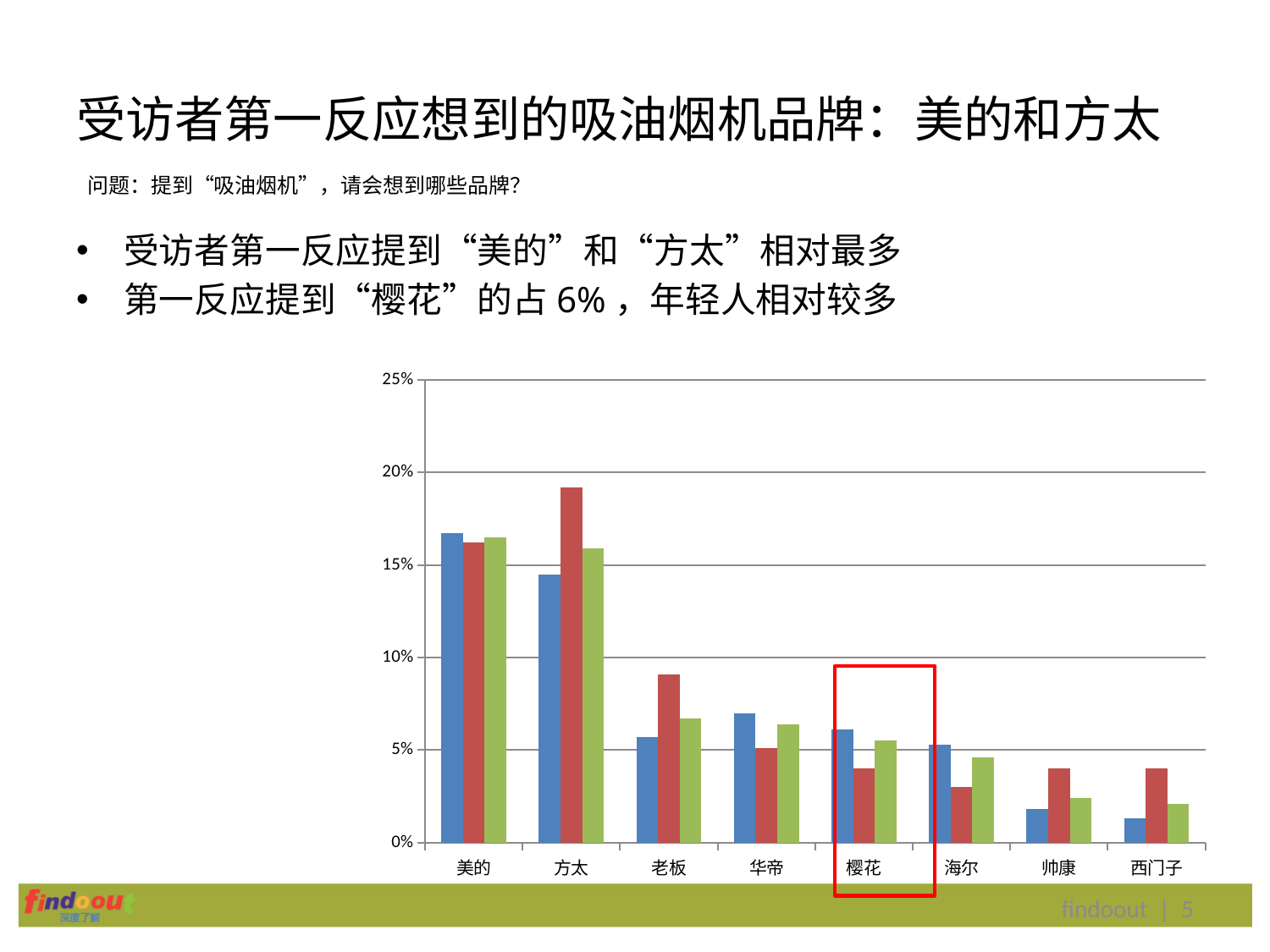
How many brand categories are shown on the x axis of the chart? 8 Which is larger, the blue bar for 美的 or the blue bar for 方太? 美的 Is the blue bar for 帅康 greater or less than 5%? less How many bars are plotted for each brand in the chart? 3 Among the red bars, which brand has the lowest value? 海尔 Which is larger, the red bar for 老板 or the green bar for 老板? red bar Is the red bar for 老板 greater or less than 10%? less Is the red bar for 方太 greater or less than 15%? greater What kind of chart is shown on the slide? bar chart Among the blue bars, which brand has the highest value? 美的 Which brand has the tallest bar in the chart? 方太 Do the bar values generally rise or fall from left to right across the brands? fall